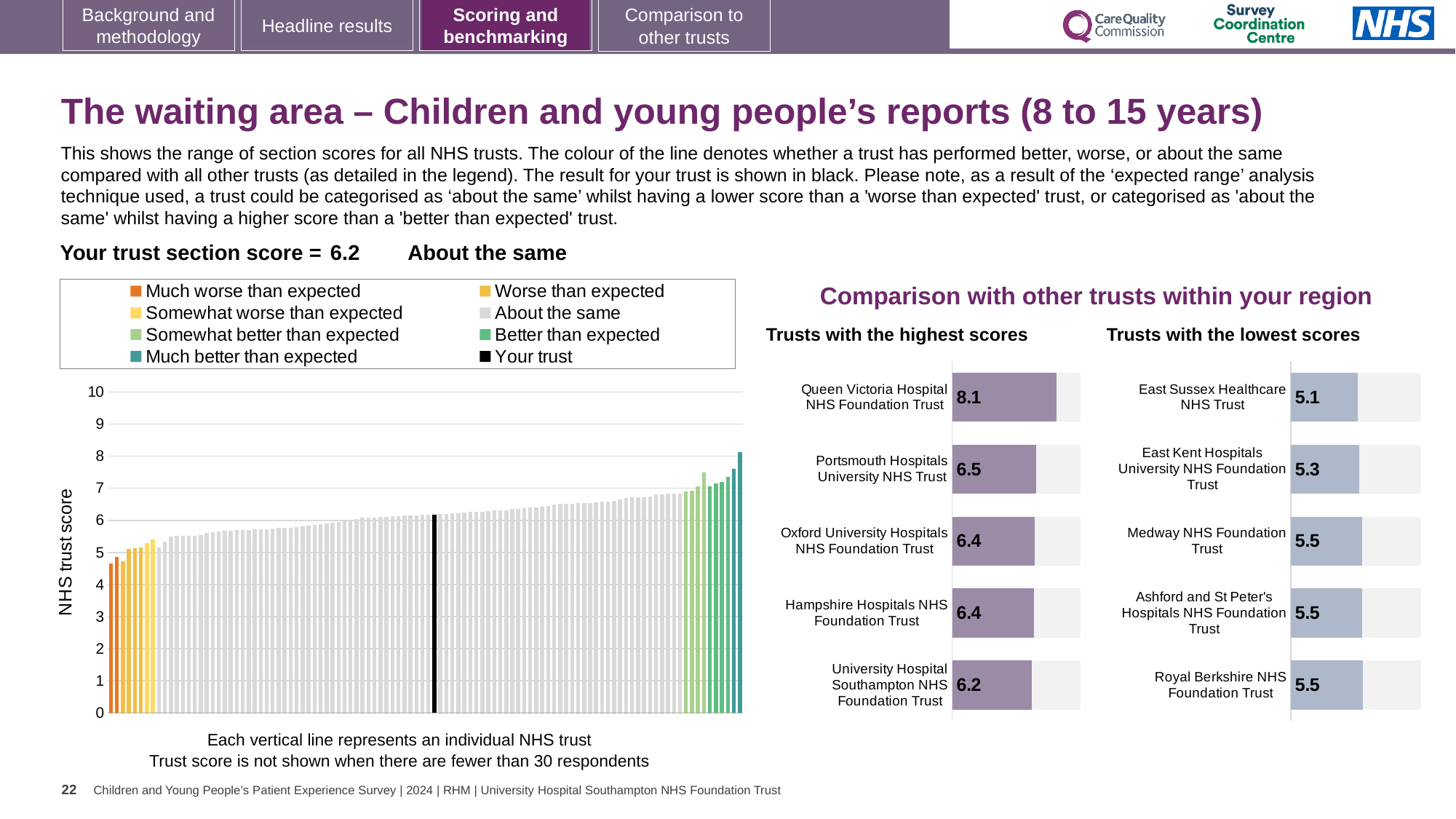
In the 'Trusts with the highest scores' chart, what is the score for Portsmouth Hospitals University NHS Trust? 6.5 What is the y-axis label of the large chart on the left? NHS trust score In the 'Trusts with the lowest scores' chart, what is the difference between the scores of Royal Berkshire NHS Foundation Trust and East Sussex Healthcare NHS Trust? 0.4 In the 'Trusts with the highest scores' chart, which has the higher score: Portsmouth Hospitals University NHS Trust or University Hospital Southampton NHS Foundation Trust? Portsmouth Hospitals University NHS Trust In the 'Trusts with the highest scores' chart, what is the difference between the scores of Queen Victoria Hospital NHS Foundation Trust and University Hospital Southampton NHS Foundation Trust? 1.9 In the 'Trusts with the highest scores' chart, what is the score for Queen Victoria Hospital NHS Foundation Trust? 8.1 In the 'Trusts with the highest scores' chart, which trust has the highest score? Queen Victoria Hospital NHS Foundation Trust In the 'Trusts with the lowest scores' chart, which trust has the lowest score? East Sussex Healthcare NHS Trust In the large chart on the left, is the value of the lowest (leftmost) bar greater or less than 5? less In the 'Trusts with the lowest scores' chart, what is the score for East Kent Hospitals University NHS Foundation Trust? 5.3 In the large chart on the left, do the bar values rise or fall from left to right? rise How many trusts are listed in the 'Trusts with the lowest scores' chart? 5